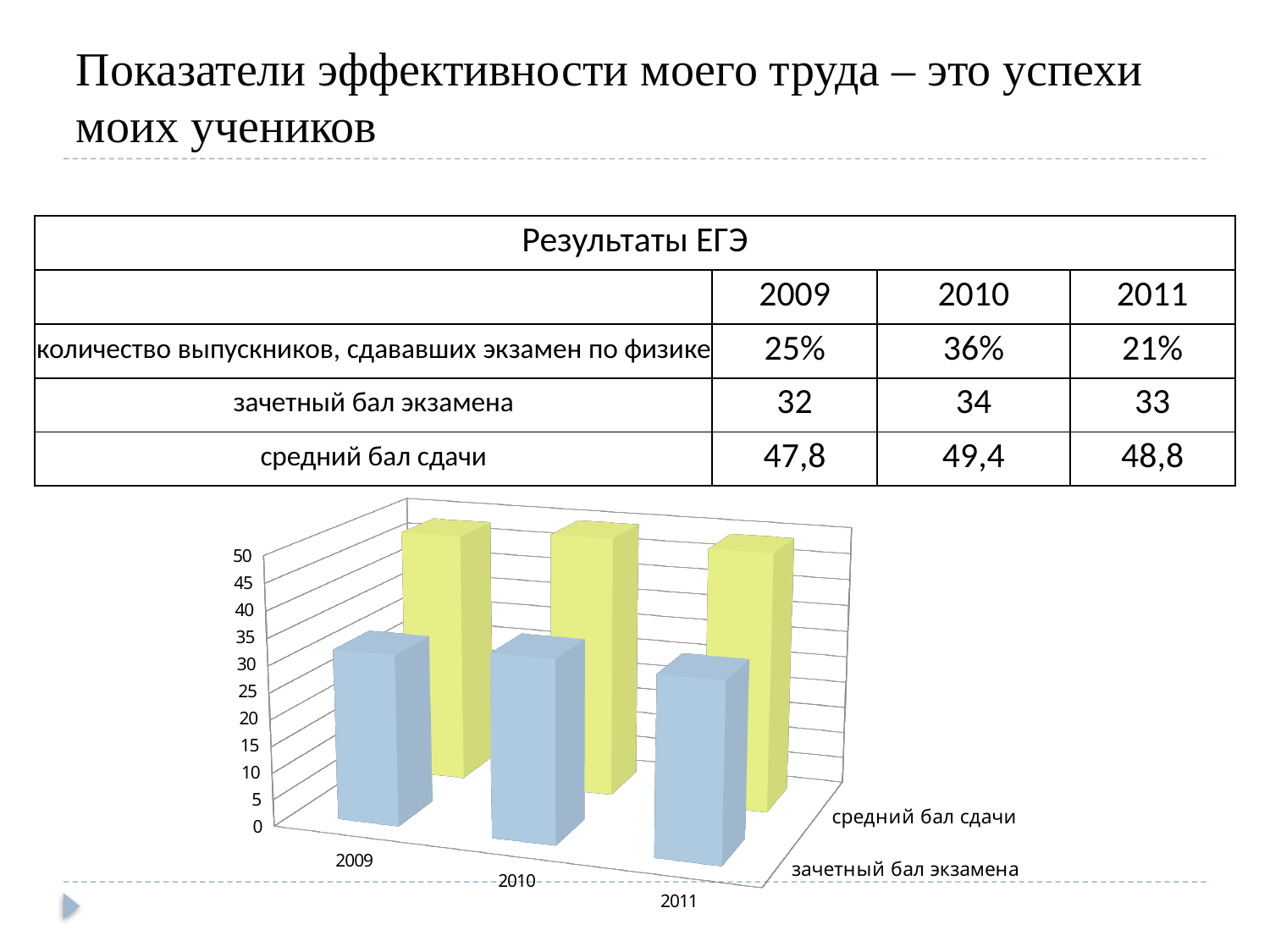
How many data series does the chart show? 2 How many years (categories) are plotted along the x axis of the chart? 3 Is the value of средний бал сдачи for 2010 greater or less than 45? greater What kind of chart is shown on the slide? bar chart What is the highest tick value shown on the vertical axis of the chart? 50 In 2011, which is larger: средний бал сдачи or зачетный бал экзамена? средний бал сдачи Is the value of зачетный бал экзамена for 2009 greater or less than 35? less What is the value of зачетный бал экзамена for 2010? 34 What is the value of средний бал сдачи for 2011? 48,8 What colour are the bars for средний бал сдачи? yellow What is the difference between средний бал сдачи and зачетный бал экзамена in 2010? 15,4 Is the value of зачетный бал экзамена for 2011 greater or less than 40? less